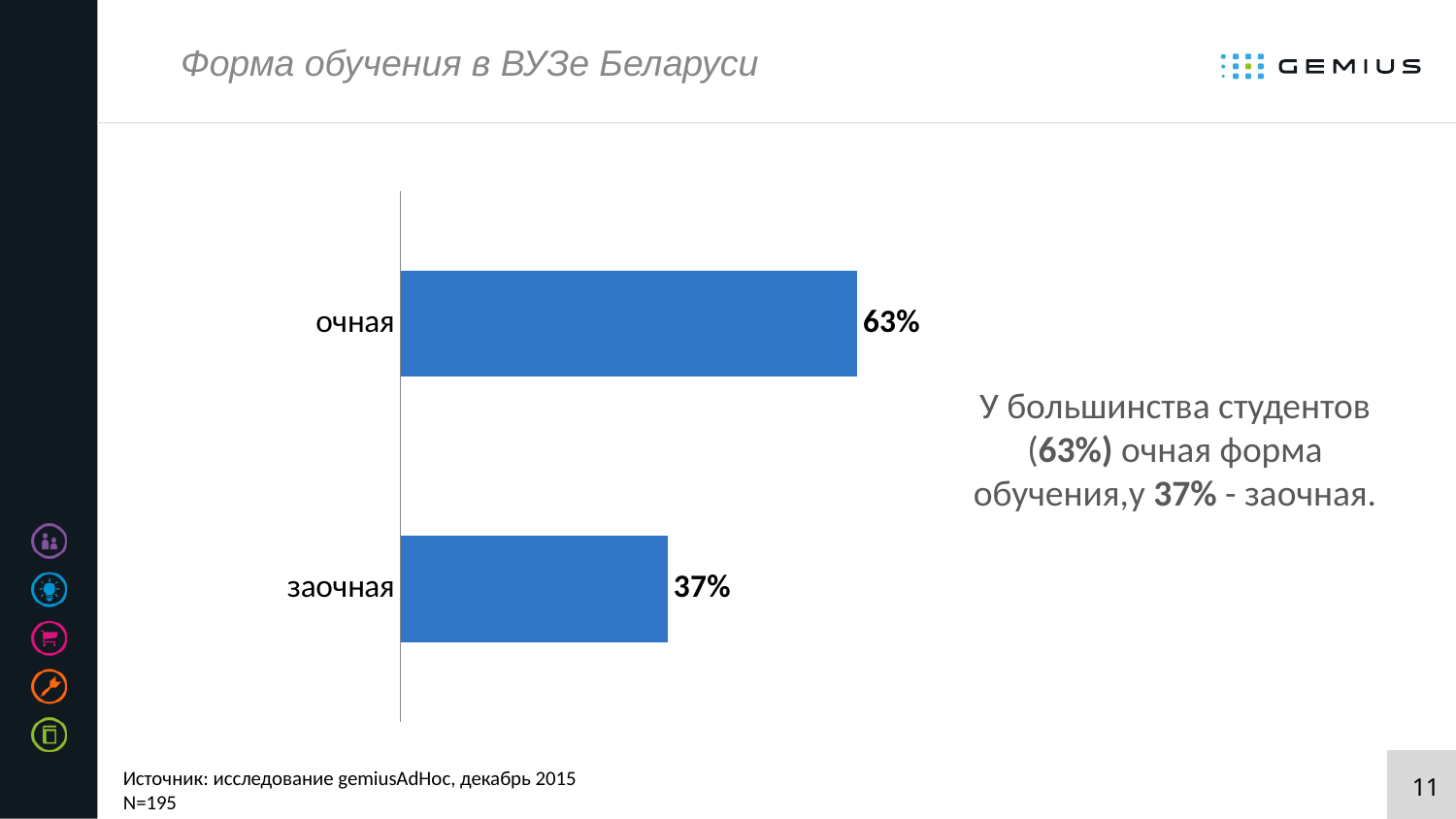
What is the total of the two values shown in the chart? 100% How many categories are shown in the chart? 2 Which is larger, the value for очная or the value for заочная? очная What is the value for очная? 63% Which category has the lowest value? заочная What is the title of the slide containing the chart? Форма обучения в ВУЗе Беларуси Which category has the highest value? очная What kind of chart is shown on the slide? bar chart What is the value for заочная? 37% What is the difference between the values for очная and заочная? 26% What colour are the bars in the chart? blue